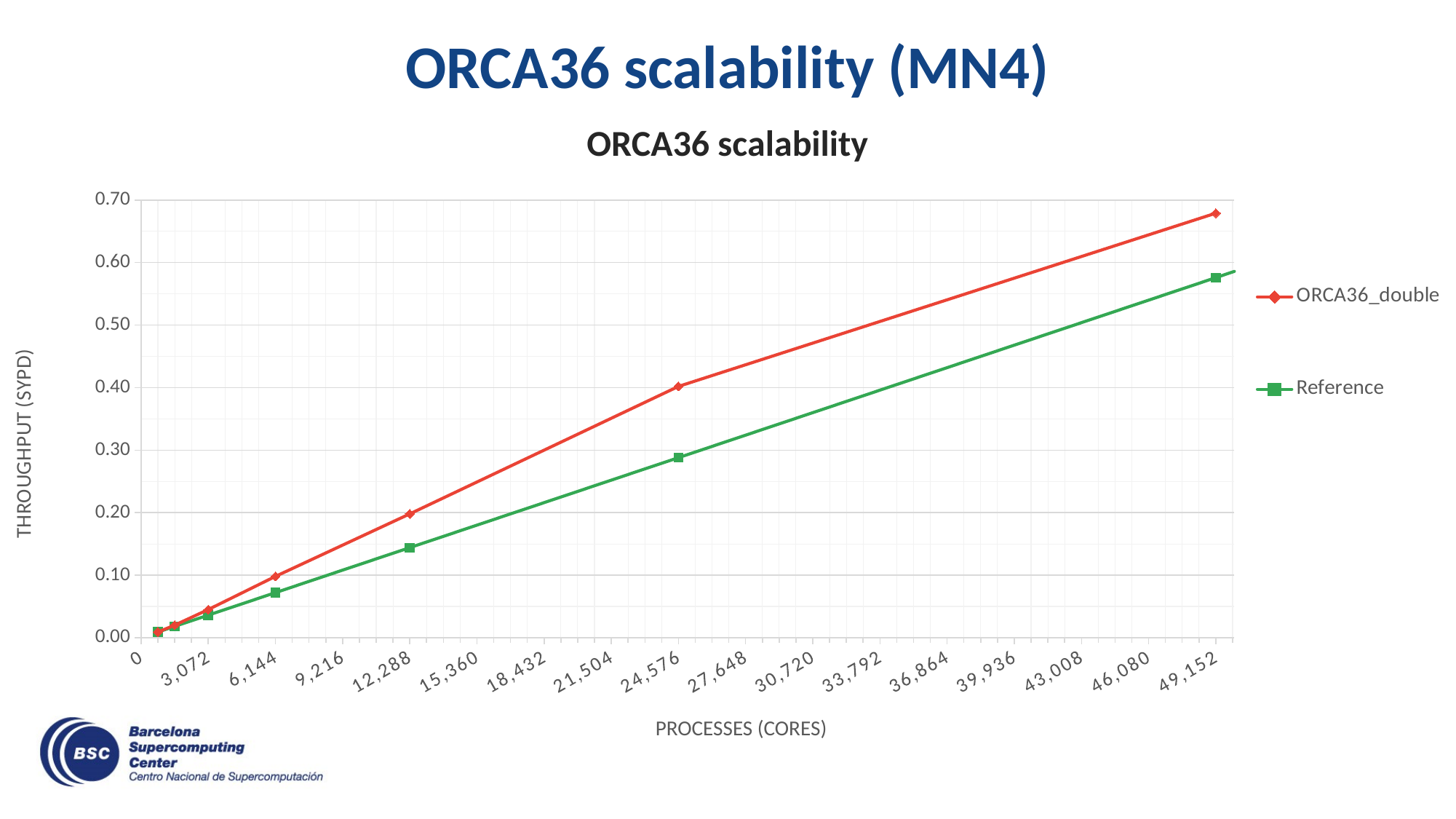
What is the label of the y axis? THROUGHPUT (SYPD) Is the throughput of ORCA36_double at 12,288 processes greater or less than 0.30? less What is the title of the chart? ORCA36 scalability Is the throughput of Reference at 49,152 processes greater or less than 0.60? less Is the throughput of ORCA36_double at 24,576 processes greater or less than 0.30? greater How many series does the legend list? 2 Which series has the lower throughput at 24,576 processes, ORCA36_double or Reference? Reference Which series has the higher throughput at 49,152 processes, ORCA36_double or Reference? ORCA36_double Does the throughput of ORCA36_double rise or fall as the number of processes increases? rise What kind of chart is shown on the slide? line chart